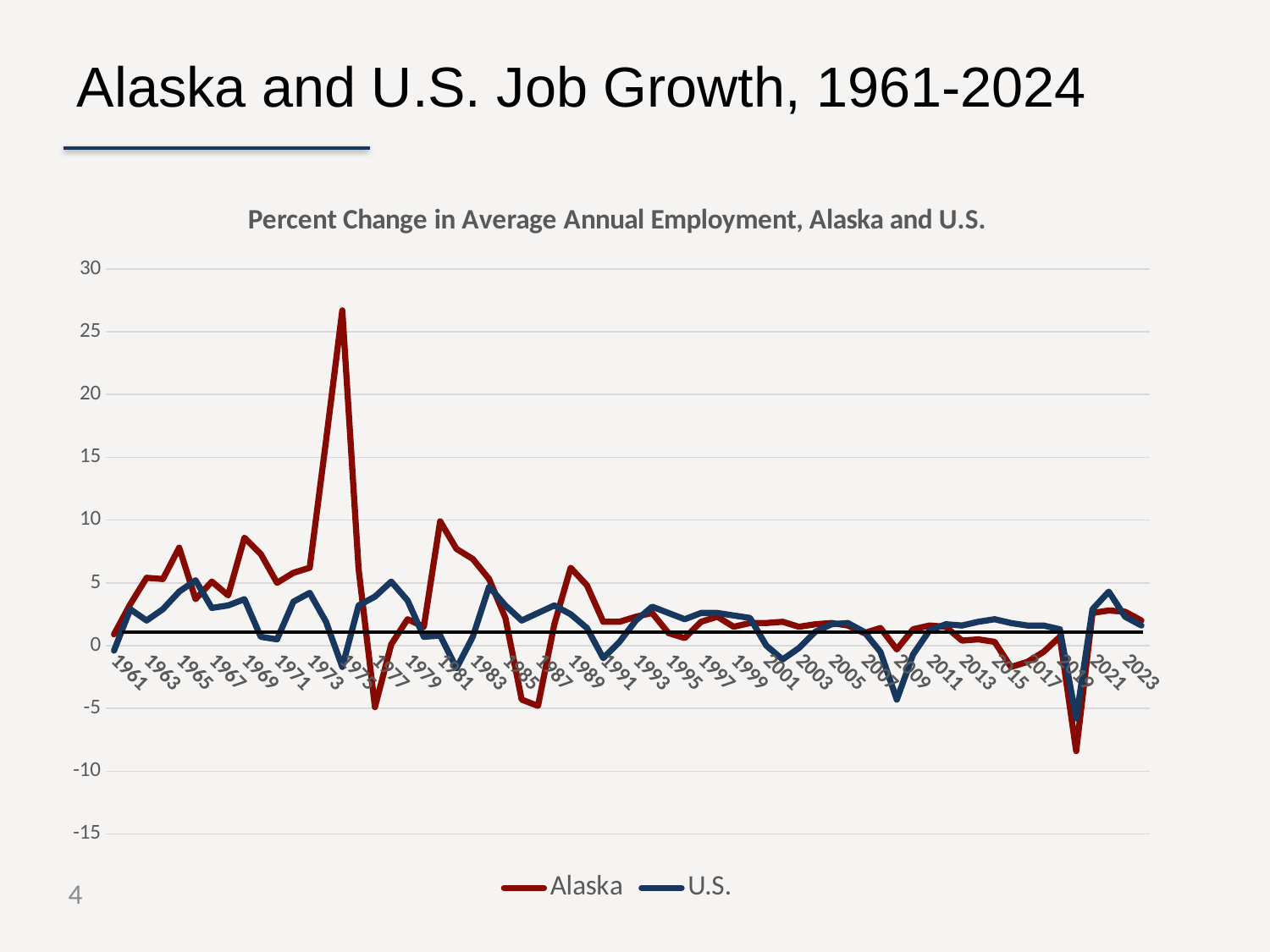
Which series has the larger value in 1975, Alaska or U.S.? Alaska Is the value for Alaska in 1981 greater or less than 5? greater What is the title of the chart? Percent Change in Average Annual Employment, Alaska and U.S. How many series does the legend list? 2 What kind of chart is shown on the slide? Line chart Is the value for U.S. in 2009 greater or less than 0? less Is the value for Alaska in 1975 greater or less than 20? greater Which series is drawn in dark red? Alaska Which series has the larger value in 2009, Alaska or U.S.? Alaska In which year does the Alaska line reach its highest value? 1975